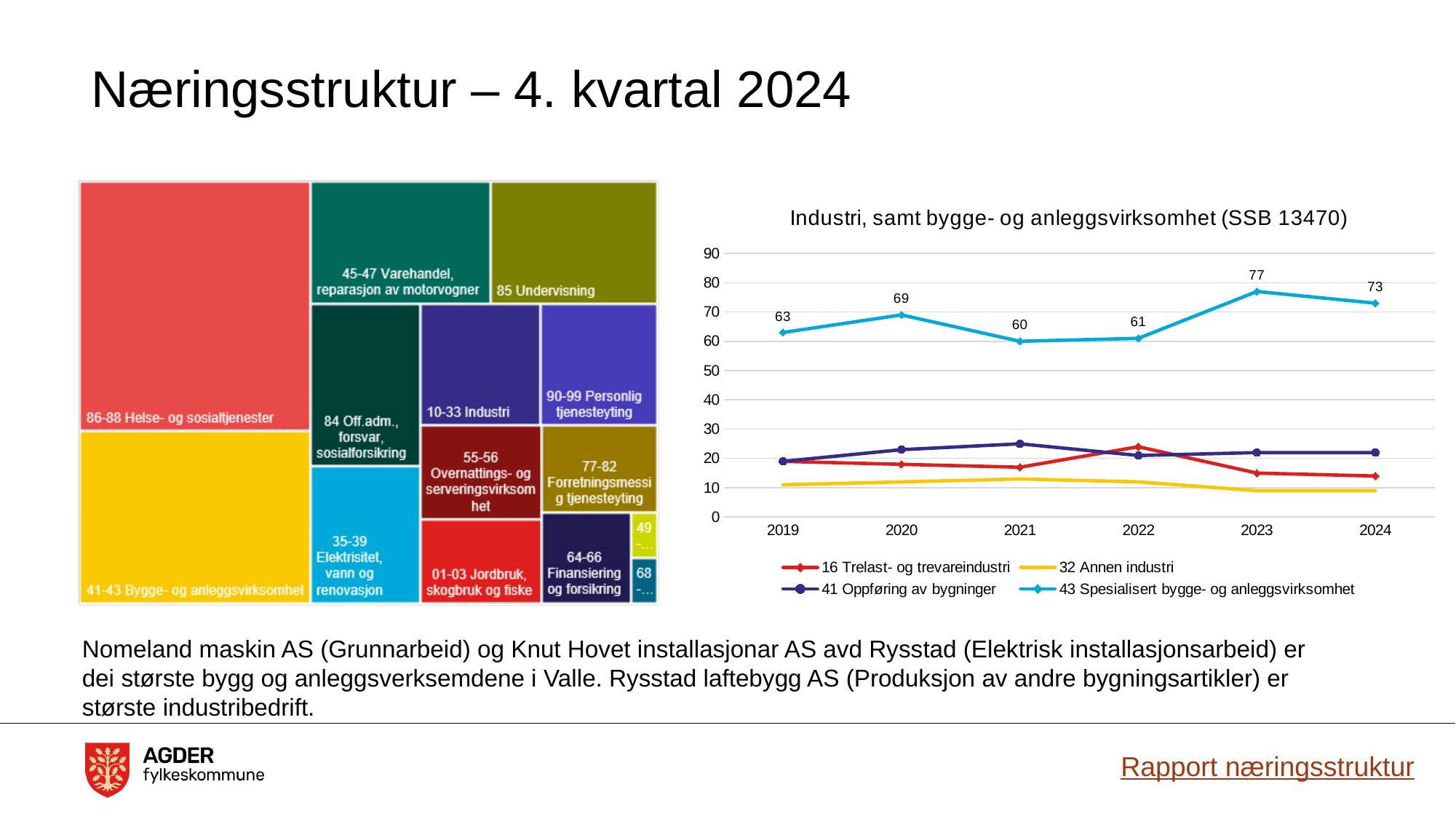
What kind of chart is the chart on the right of the slide? Line chart In the line chart 'Industri, samt bygge- og anleggsvirksomhet (SSB 13470)', what is the value for 43 Spesialisert bygge- og anleggsvirksomhet in 2024? 73 In the line chart 'Industri, samt bygge- og anleggsvirksomhet (SSB 13470)', is the value for 16 Trelast- og trevareindustri in 2022 greater or less than 20? greater In the line chart 'Industri, samt bygge- og anleggsvirksomhet (SSB 13470)', in which year does 43 Spesialisert bygge- og anleggsvirksomhet reach its highest value? 2023 How many years are shown on the x axis of the line chart 'Industri, samt bygge- og anleggsvirksomhet (SSB 13470)'? 6 In the line chart 'Industri, samt bygge- og anleggsvirksomhet (SSB 13470)', what is the difference between the 2023 and 2019 values for 43 Spesialisert bygge- og anleggsvirksomhet? 14 In the line chart 'Industri, samt bygge- og anleggsvirksomhet (SSB 13470)', what is the value for 43 Spesialisert bygge- og anleggsvirksomhet in 2019? 63 In the line chart 'Industri, samt bygge- og anleggsvirksomhet (SSB 13470)', which is larger for 43 Spesialisert bygge- og anleggsvirksomhet: the 2020 value or the 2024 value? 2024 In the line chart 'Industri, samt bygge- og anleggsvirksomhet (SSB 13470)', is the value for 32 Annen industri in 2019 greater or less than 20? less How many series does the legend of the line chart 'Industri, samt bygge- og anleggsvirksomhet (SSB 13470)' list? 4 In the treemap on the left of the slide, which category occupies the largest area? 86-88 Helse- og sosialtjenester In the line chart 'Industri, samt bygge- og anleggsvirksomhet (SSB 13470)', in which year does 43 Spesialisert bygge- og anleggsvirksomhet have its lowest value? 2021